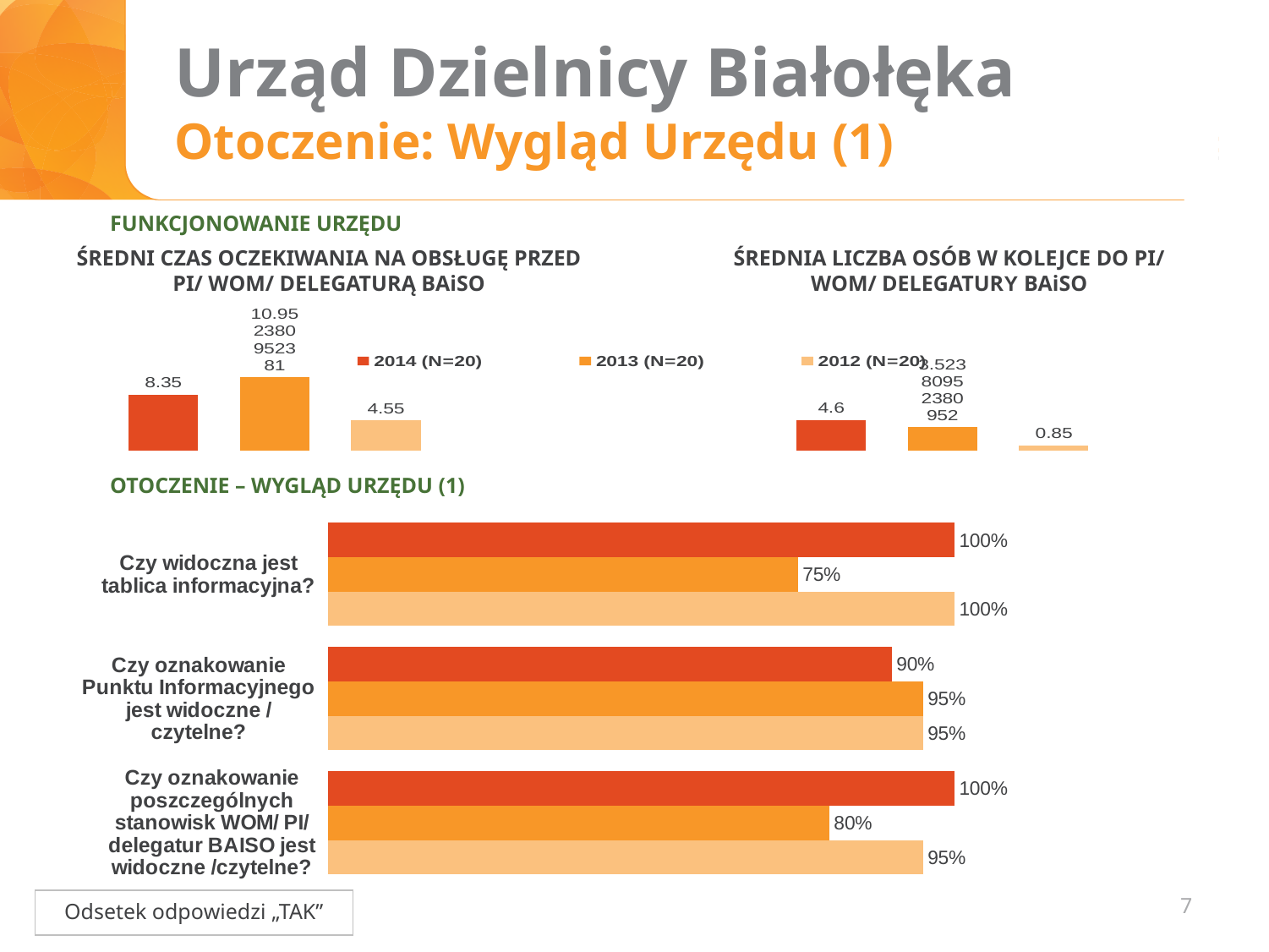
In the chart 'ŚREDNI CZAS OCZEKIWANIA NA OBSŁUGĘ PRZED PI/ WOM/ DELEGATURĄ BAiSO', what is the value for 2014 (N=20)? 8.35 How many series does the legend on the slide list? 3 In the chart 'ŚREDNI CZAS OCZEKIWANIA NA OBSŁUGĘ PRZED PI/ WOM/ DELEGATURĄ BAiSO', which year has the highest value? 2013 (N=20) In the bottom chart 'OTOCZENIE – WYGLĄD URZĘDU (1)', which is larger for 'Czy widoczna jest tablica informacyjna?': the 2014 value or the 2013 value? 2014 In the bottom chart 'OTOCZENIE – WYGLĄD URZĘDU (1)', what is the difference between the 2014 and 2013 values for 'Czy oznakowanie poszczególnych stanowisk WOM/ PI/ delegatur BAISO jest widoczne /czytelne?'? 20% In the bottom chart 'OTOCZENIE – WYGLĄD URZĘDU (1)', what is the 2014 value for 'Czy oznakowanie Punktu Informacyjnego jest widoczne / czytelne?'? 90% In the chart 'ŚREDNI CZAS OCZEKIWANIA NA OBSŁUGĘ PRZED PI/ WOM/ DELEGATURĄ BAiSO', what is the value for 2012 (N=20)? 4.55 How many question categories are shown in the bottom chart 'OTOCZENIE – WYGLĄD URZĘDU (1)'? 3 In the bottom chart 'OTOCZENIE – WYGLĄD URZĘDU (1)', what is the 2013 value for 'Czy widoczna jest tablica informacyjna?'? 75% In the chart 'ŚREDNIA LICZBA OSÓB W KOLEJCE DO PI/ WOM/ DELEGATURY BAiSO', which year has the lowest value? 2012 (N=20) In the chart 'ŚREDNIA LICZBA OSÓB W KOLEJCE DO PI/ WOM/ DELEGATURY BAiSO', what is the value for 2014 (N=20)? 4.6 In the chart 'ŚREDNIA LICZBA OSÓB W KOLEJCE DO PI/ WOM/ DELEGATURY BAiSO', what is the value for 2012 (N=20)? 0.85